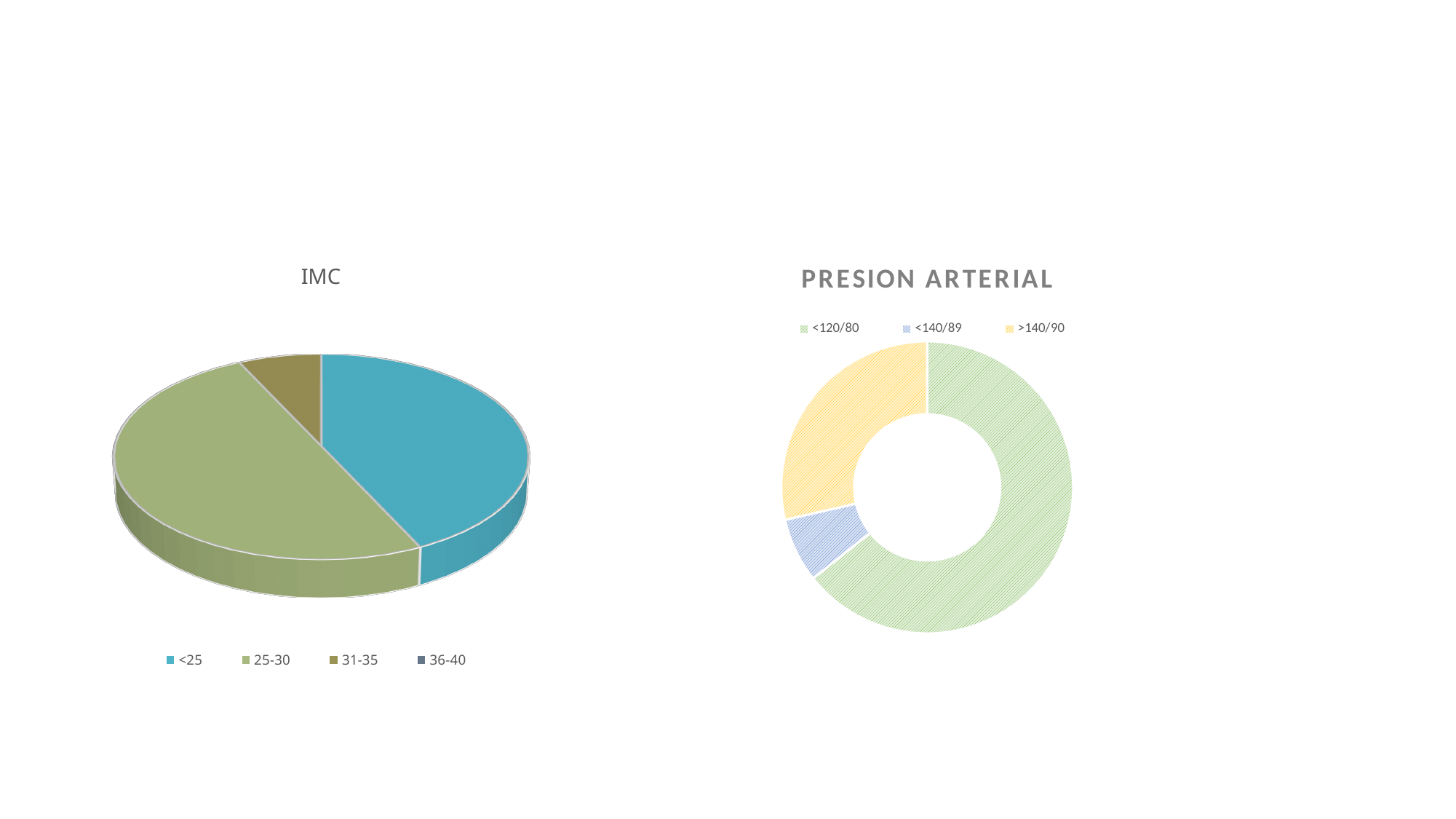
What kind of chart is the PRESION ARTERIAL chart? doughnut chart In the PRESION ARTERIAL chart, which is larger, the share for >140/90 or the share for <140/89? >140/90 In the IMC chart, which is larger, the slice for 31-35 or the slice for <25? <25 In the PRESION ARTERIAL chart, which category has the largest share? <120/80 How many categories does the legend of the PRESION ARTERIAL chart list? 3 In the IMC chart, what colour is the slice for <25? blue What is the title of the chart on the right side of the slide? PRESION ARTERIAL How many categories does the legend of the IMC chart list? 4 What kind of chart is the IMC chart? pie chart In the IMC chart, which category has the largest slice? 25-30 In the IMC chart, which is larger, the slice for <25 or the slice for 25-30? 25-30 In the PRESION ARTERIAL chart, which category has the smallest share? <140/89